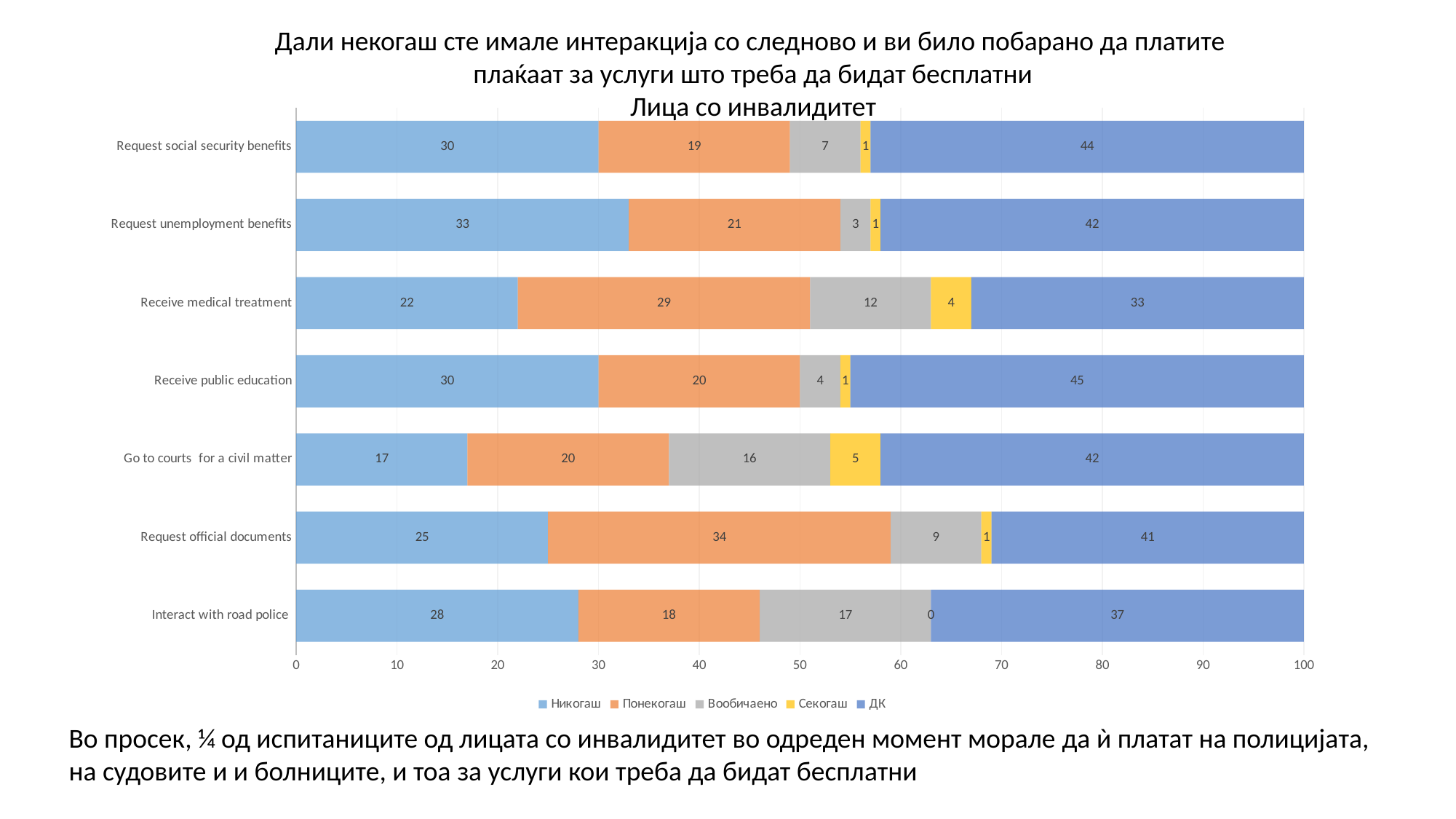
What is the value of ДК for Interact with road police? 37 What is the value of Секогаш for Interact with road police? 0 Which category has the lowest value for Никогаш? Go to courts for a civil matter Which category has the highest value for Понекогаш? Request official documents What kind of chart is shown on the slide? bar chart What is the value of Никогаш for Receive medical treatment? 22 Which series is shown in yellow in the legend? Секогаш For Request unemployment benefits, what is the difference between the Никогаш value and the Понекогаш value? 12 Which has the larger Вообичаено value: Go to courts for a civil matter or Receive medical treatment? Go to courts for a civil matter How many categories are plotted on the chart? 7 How many series does the legend list? 5 What is the value of Понекогаш for Request official documents? 34